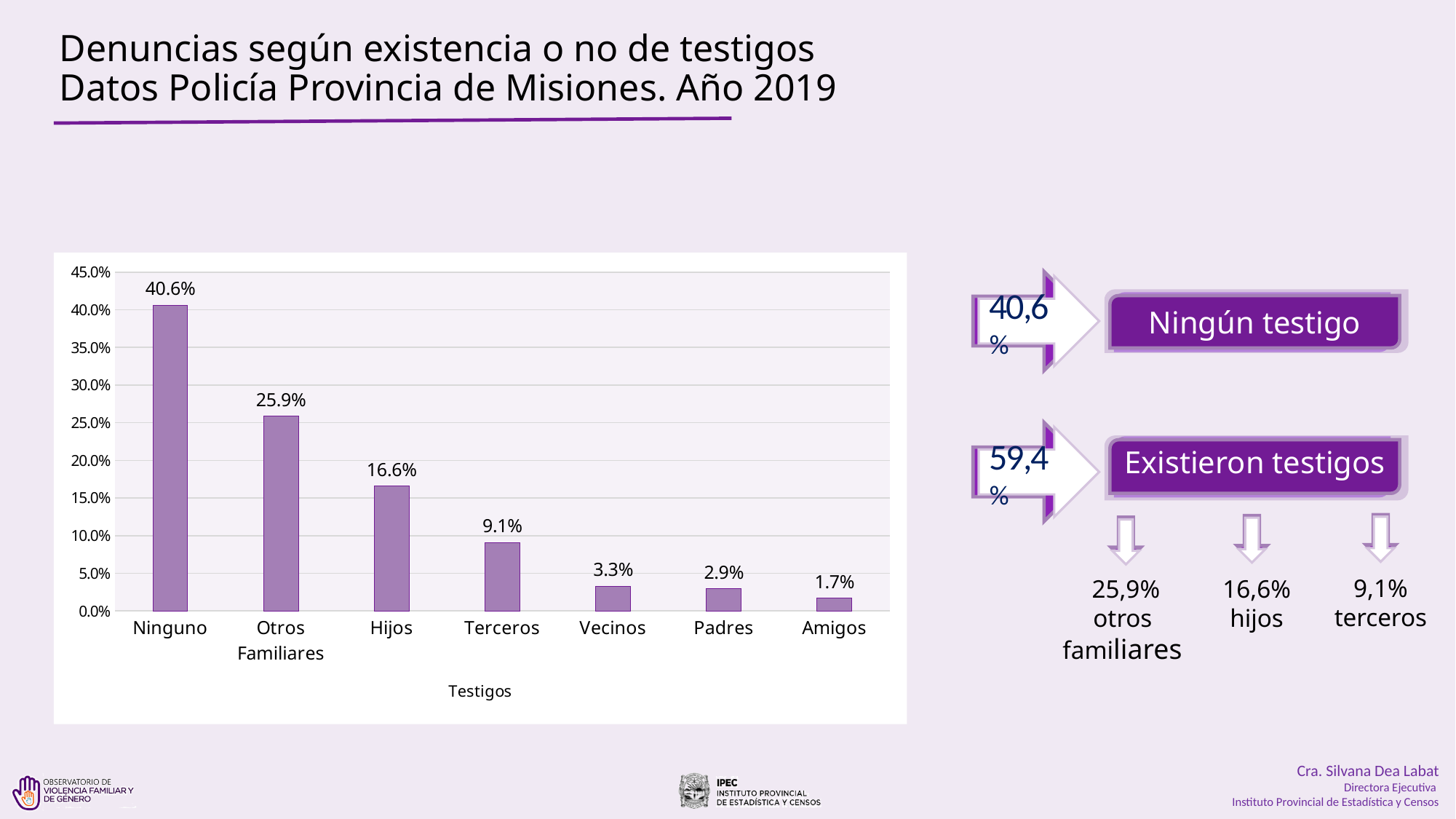
How many categories are shown on the x axis? 7 What is the value for Vecinos? 3.3% Which is larger, the value for Terceros or the value for Padres? Terceros Which category has the lowest value? Amigos What is the value for Hijos? 16.6% Which category has the highest value? Ninguno Is the value for Hijos greater or less than 20.0%? less What is the x-axis title of the chart? Testigos What is the difference between the values for Ninguno and Otros Familiares? 14.7% What is the value for Otros Familiares? 25.9% What kind of chart is shown on the slide? bar chart What is the value for Ninguno? 40.6%